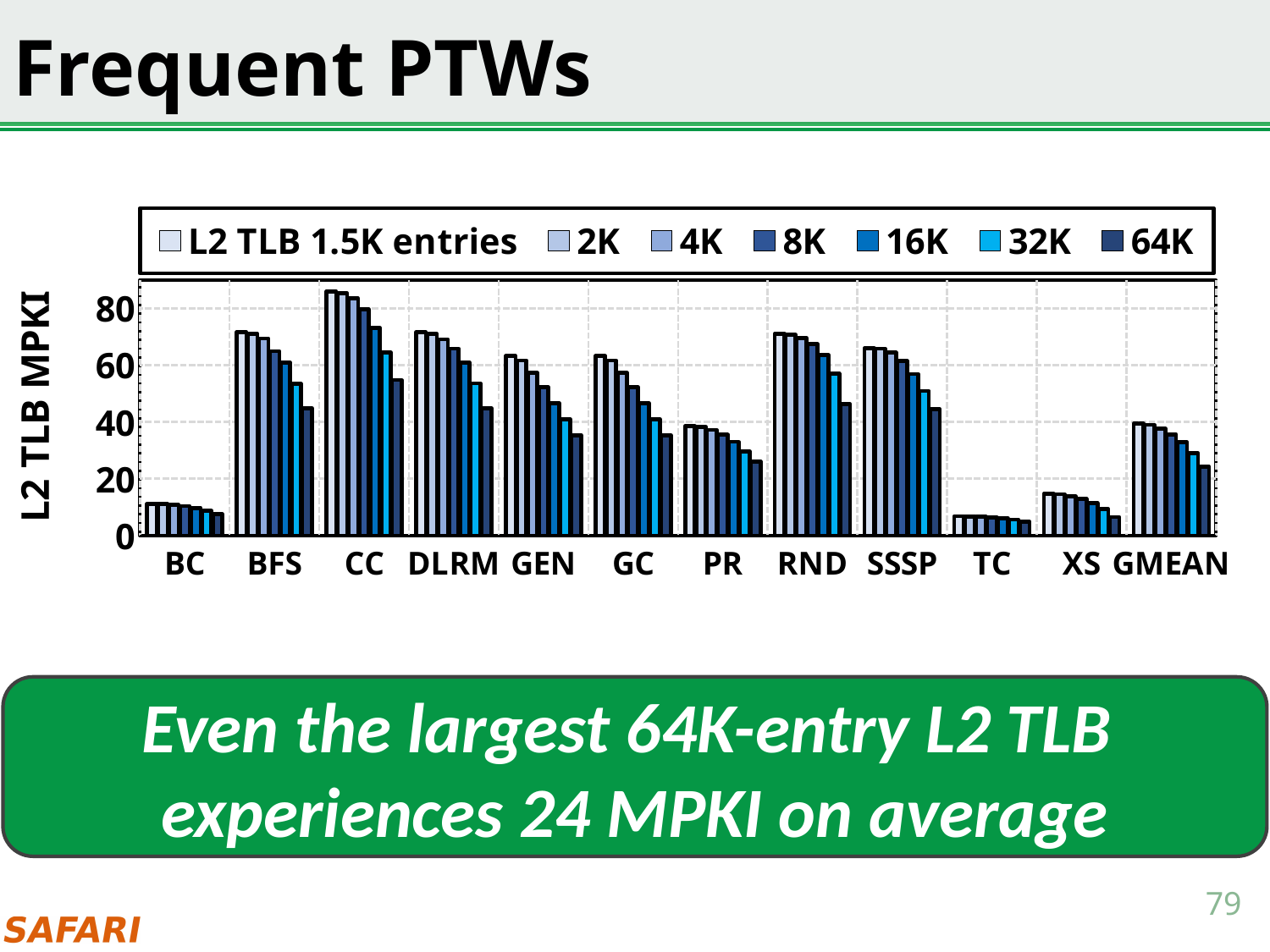
What is the label of the y axis of the chart? L2 TLB MPKI Within each workload group, do the bars rise or fall as the L2 TLB size increases from 1.5K entries to 64K? fall Is the L2 TLB MPKI for CC with L2 TLB 1.5K entries greater or less than 80? greater How many categories (workloads) are shown along the x axis of the chart? 12 Is the L2 TLB MPKI for TC with L2 TLB 1.5K entries greater or less than 20? less Which workload has the highest L2 TLB MPKI for the L2 TLB 1.5K entries series? CC Which workload has the lowest L2 TLB MPKI for the L2 TLB 1.5K entries series? TC Is the L2 TLB MPKI for RND with L2 TLB 1.5K entries greater or less than 60? greater What kind of chart is shown on the slide? bar chart How many series does the chart's legend list? 7 For the L2 TLB 1.5K entries series, which is larger: the value for CC or the value for BFS? CC